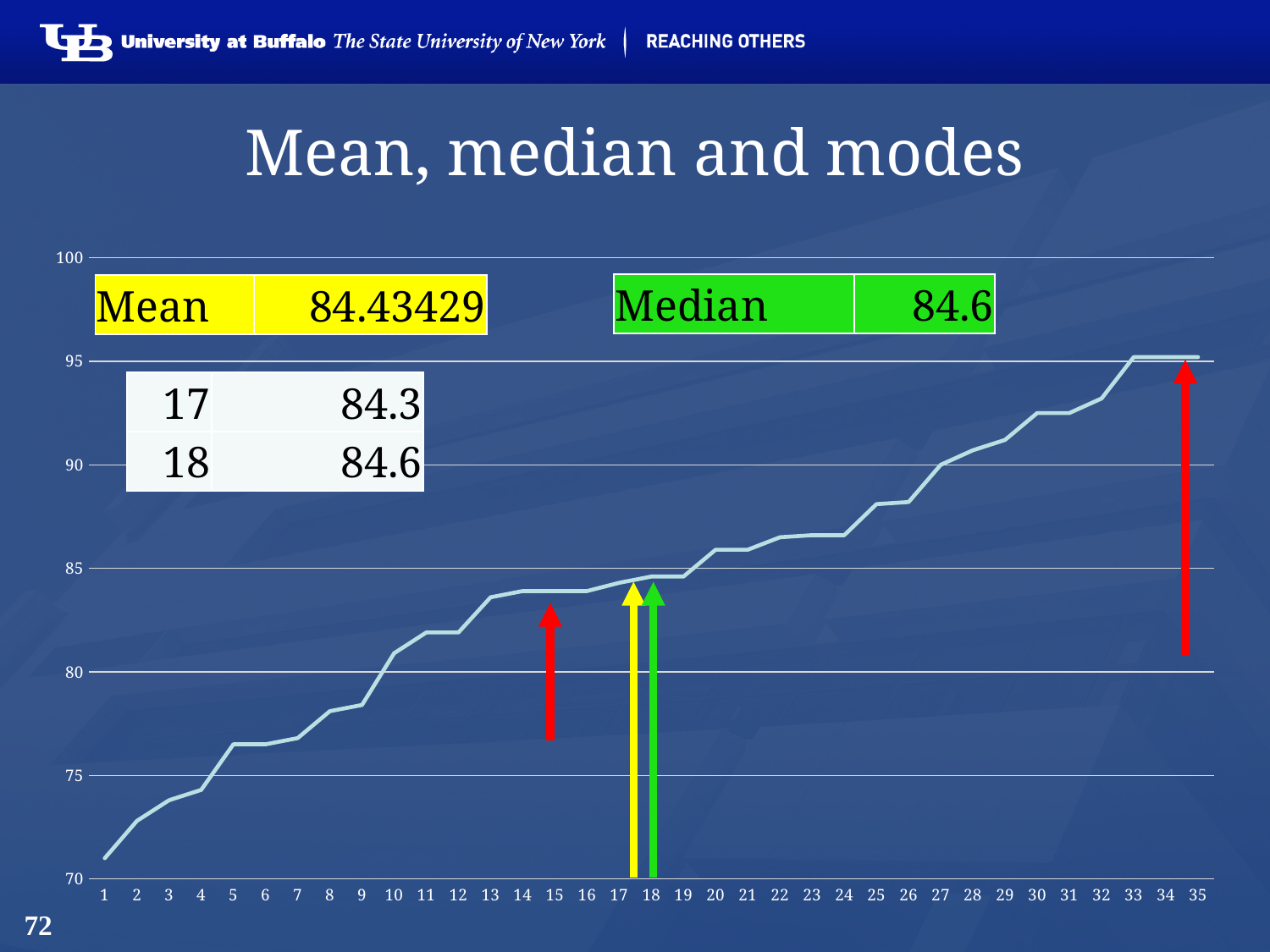
Is the value for point 10 greater or less than 80? greater What is the difference between the values for point 18 and point 17? 0.3 How many points are plotted along the x axis of the chart? 35 Is the value for point 1 greater or less than 75? less What kind of chart is shown on the slide? line chart Do the plotted values rise or fall as the x axis goes from 1 to 35? rise What mean value is shown in the yellow box on the chart? 84.43429 Is the value for point 30 greater or less than 90? greater What is the value for point 17 according to the table on the chart? 84.3 Which has the larger value, point 10 or point 30? 30 Which point on the x axis has the lowest value? 1 What is the value for point 18 according to the table on the chart? 84.6